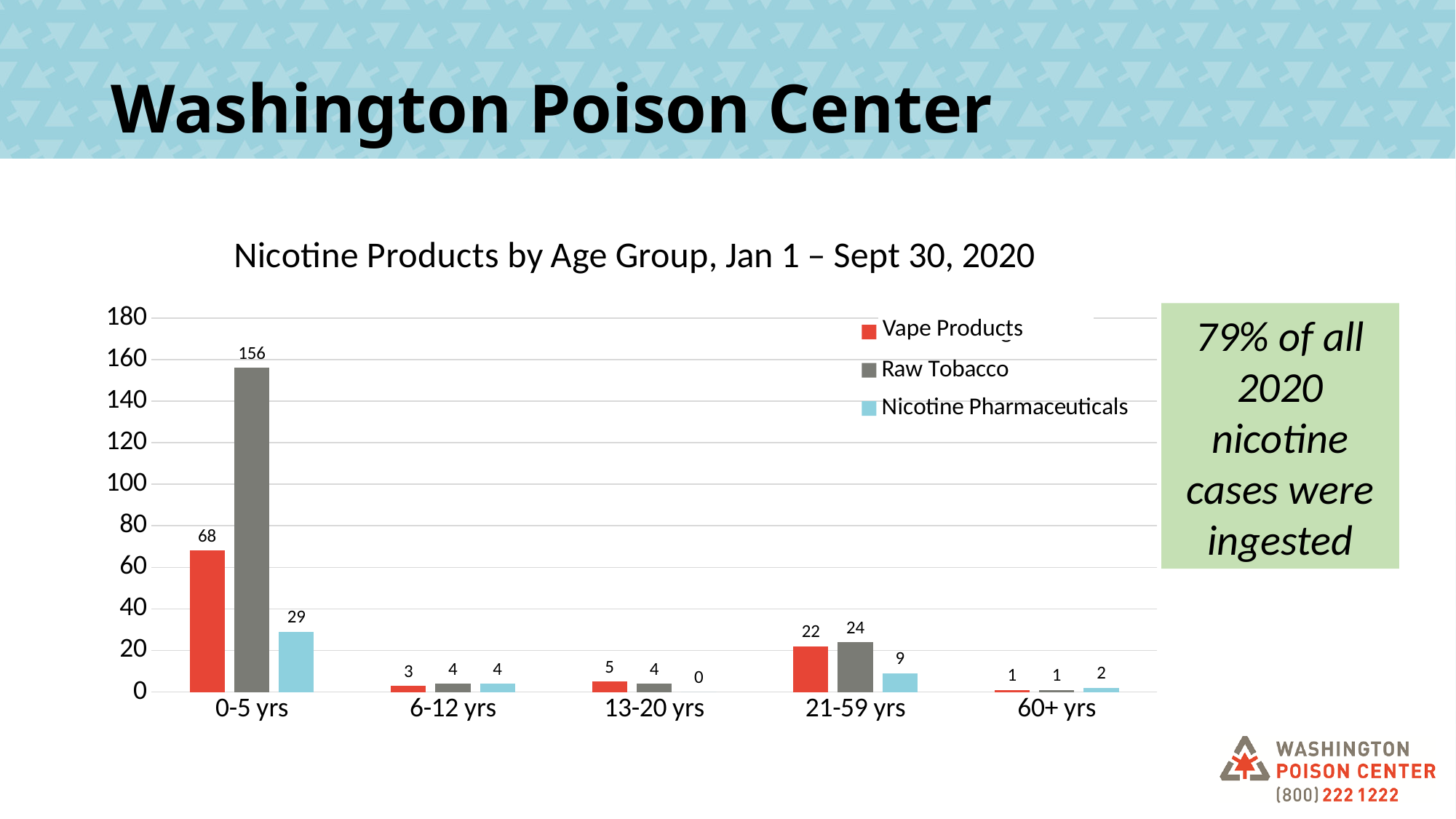
Which age group has the lowest value for Vape Products? 60+ yrs Which age group has the highest value for Raw Tobacco? 0-5 yrs What is the title of the chart? Nicotine Products by Age Group, Jan 1 – Sept 30, 2020 How many age groups are shown on the x axis? 5 What kind of chart is shown on the slide? Bar chart What is the difference between Raw Tobacco and Vape Products in the 0-5 yrs age group? 88 Which is larger in the 21-59 yrs age group, Vape Products or Nicotine Pharmaceuticals? Vape Products How many series does the legend list? 3 What is the value for Raw Tobacco in the 0-5 yrs age group? 156 Is the value for Vape Products in the 0-5 yrs age group greater or less than 60? greater What is the value for Vape Products in the 21-59 yrs age group? 22 What is the value for Nicotine Pharmaceuticals in the 13-20 yrs age group? 0